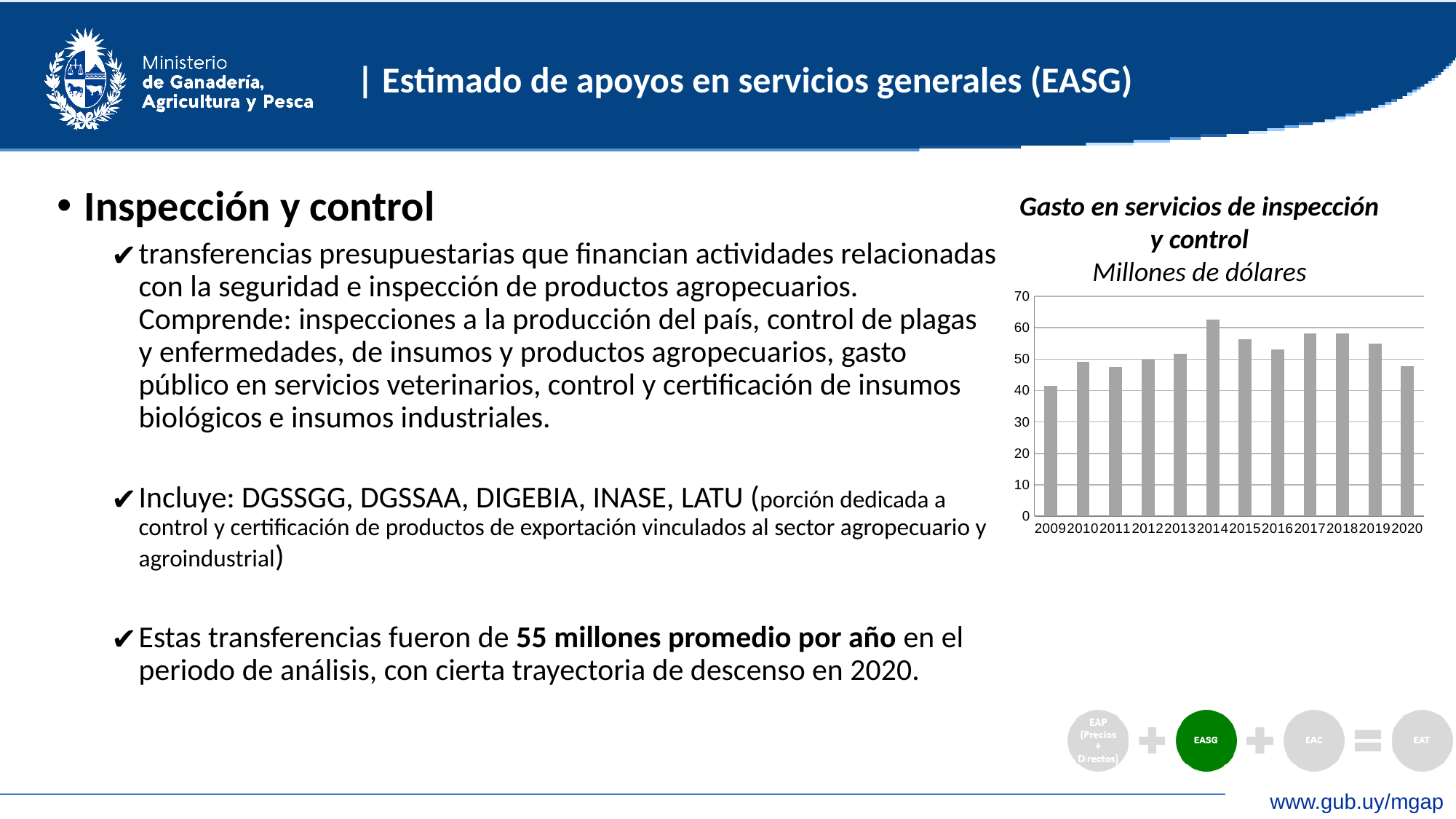
Do the values rise or fall from 2018 to 2020? fall How many years are shown on the x axis of the chart? 12 Which is larger, the value for 2014 or the value for 2020? 2014 Is the value for 2014 greater or less than 60? greater In what units are the values of the chart expressed? Millones de dólares Which is larger, the value for 2009 or the value for 2017? 2017 What kind of chart is shown on the slide? bar chart What is the title of the chart on the slide? Gasto en servicios de inspección y control Which year has the highest value in the chart? 2014 Is the value for 2017 greater or less than 50? greater Is the value for 2009 greater or less than 50? less Which year has the lowest value in the chart? 2009